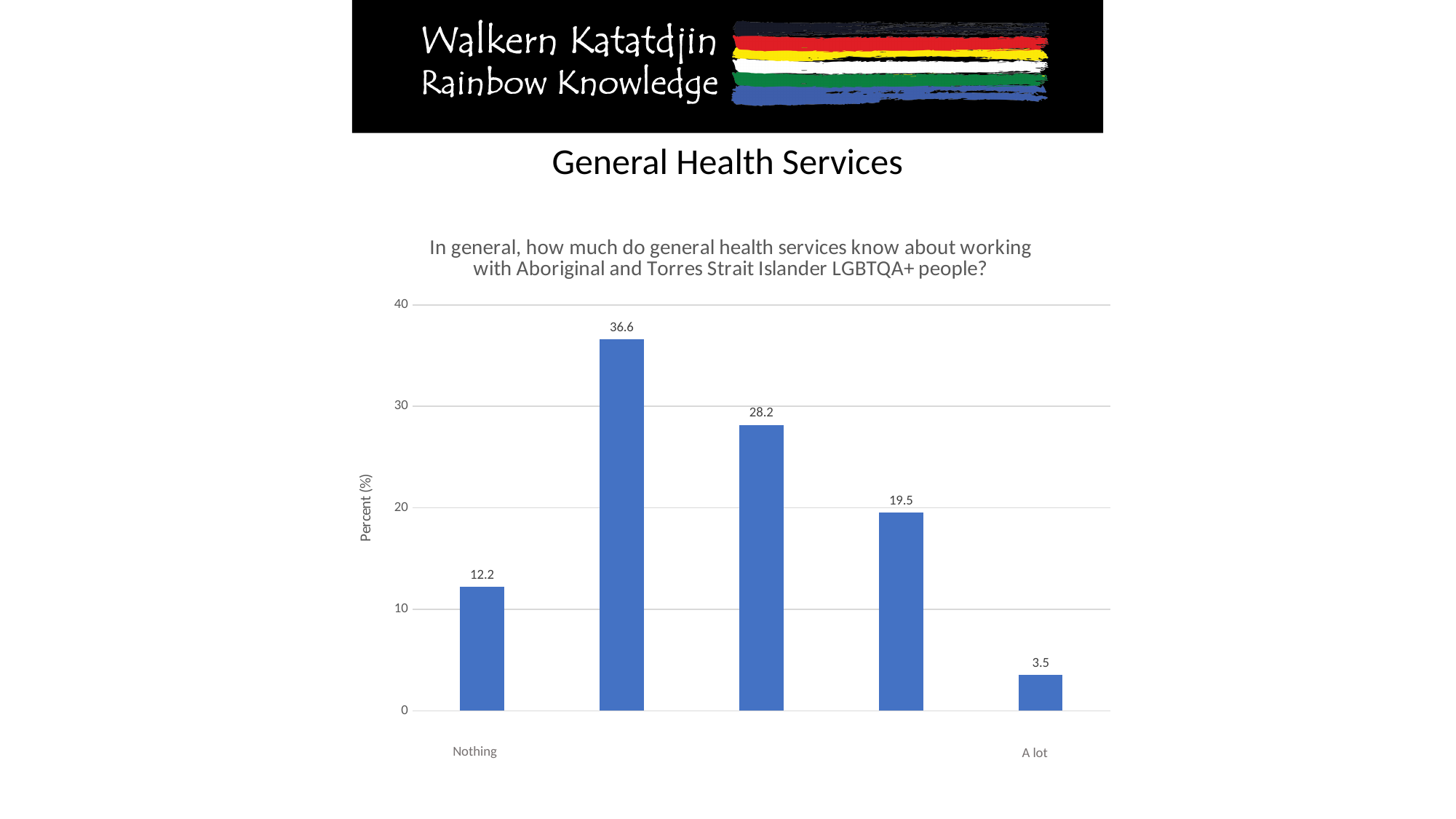
What is the difference between the values for "Nothing" and "A lot"? 8.7 What is the label of the vertical axis? Percent (%) How many bars are plotted in the chart? 5 Is the value for "Nothing" greater or less than 10? greater What is the highest tick value shown on the vertical axis? 40 Which is larger, the value for "Nothing" or the value for "A lot"? Nothing What is the value for "Nothing"? 12.2 What kind of chart is shown on the slide? bar chart What is the value for "A lot"? 3.5 Which category has the lowest value? A lot What is the value of the tallest bar? 36.6 What is the value of the second bar from the left? 36.6